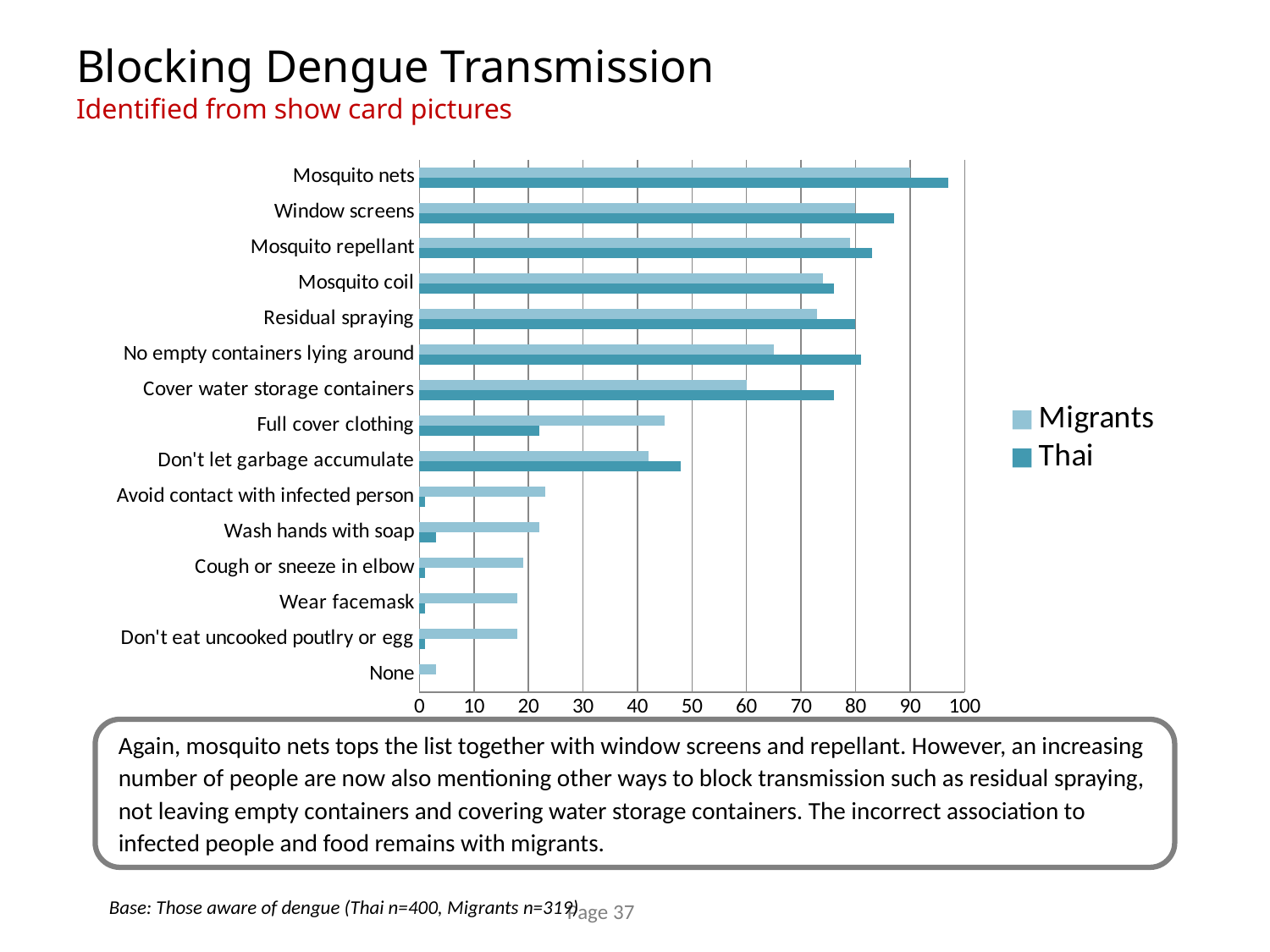
Which category has the highest value for Migrants? Mosquito nets For Full cover clothing, which series has the larger value, Migrants or Thai? Migrants Is the Migrants value for Mosquito nets greater or less than 80? greater How many series does the legend list? 2 For No empty containers lying around, which series has the larger value, Migrants or Thai? Thai Is the Migrants value for Wash hands with soap greater or less than 30? less How many categories are plotted on the chart? 15 What kind of chart is shown on the slide? bar chart Which category has the highest value for Thai? Mosquito nets Is the Thai value for Full cover clothing greater or less than 30? less Which category has the lowest value for Migrants? None